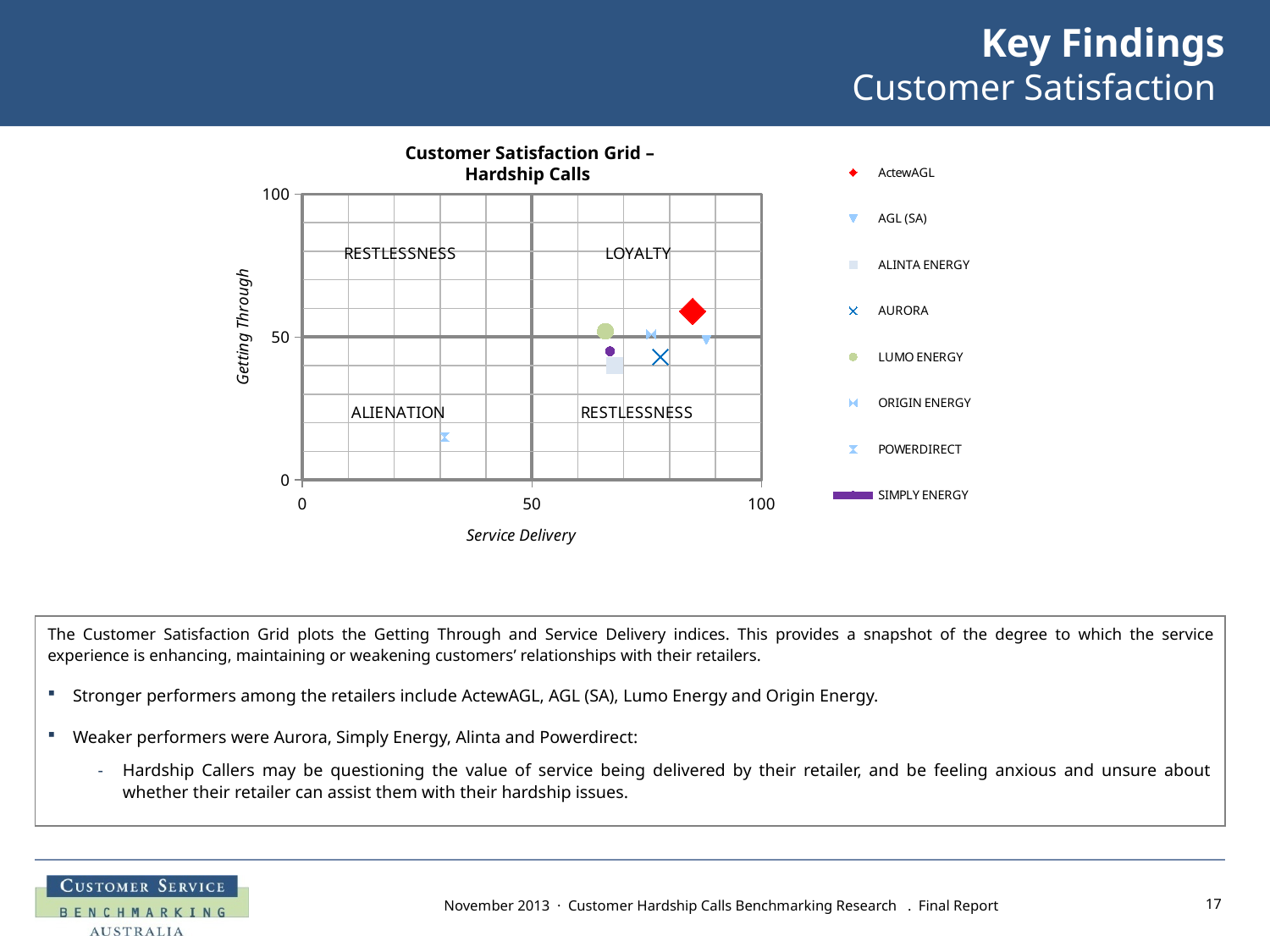
What kind of chart is the Customer Satisfaction Grid – Hardship Calls? Scatter chart Is the Service Delivery value for Alinta Energy greater or less than 50? greater Is the Getting Through value for Powerdirect greater or less than 50? less What is the label of the horizontal axis of the Customer Satisfaction Grid? Service Delivery Which retailer has the lowest Service Delivery value on the Customer Satisfaction Grid? Powerdirect Is the Service Delivery value for Powerdirect greater or less than 50? less Which retailer has the highest Getting Through value on the Customer Satisfaction Grid? ActewAGL How many retailers does the legend of the Customer Satisfaction Grid list? 8 What label is shown in the top-right quadrant of the Customer Satisfaction Grid? LOYALTY